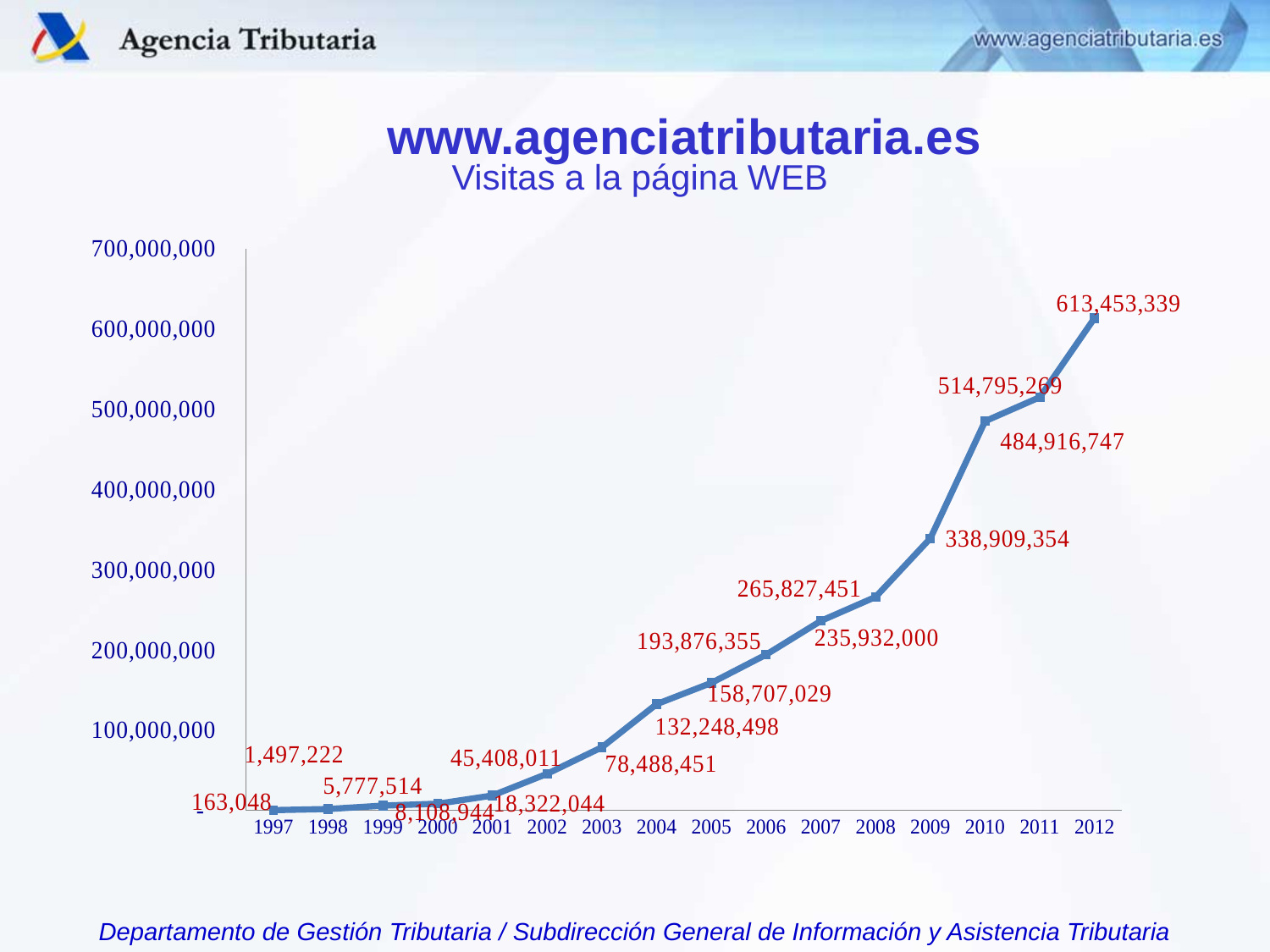
Which year has the highest number of visits? 2012 How many visits to the web page are shown for 2012? 613,453,339 What is the value plotted for 1997? 163,048 What is the difference between the values for 2012 and 2010? 128,536,592 What is the value plotted for 2003? 78,488,451 Which year has the lowest number of visits? 1997 How many years are plotted on the x axis? 16 Do the values rise or fall from 1997 to 2012? Rise What is the difference between the values for 2009 and 2008? 73,081,903 What is the value plotted for 2009? 338,909,354 What kind of chart is shown on the slide? Line chart Which year has a larger value, 2006 or 2007? 2007